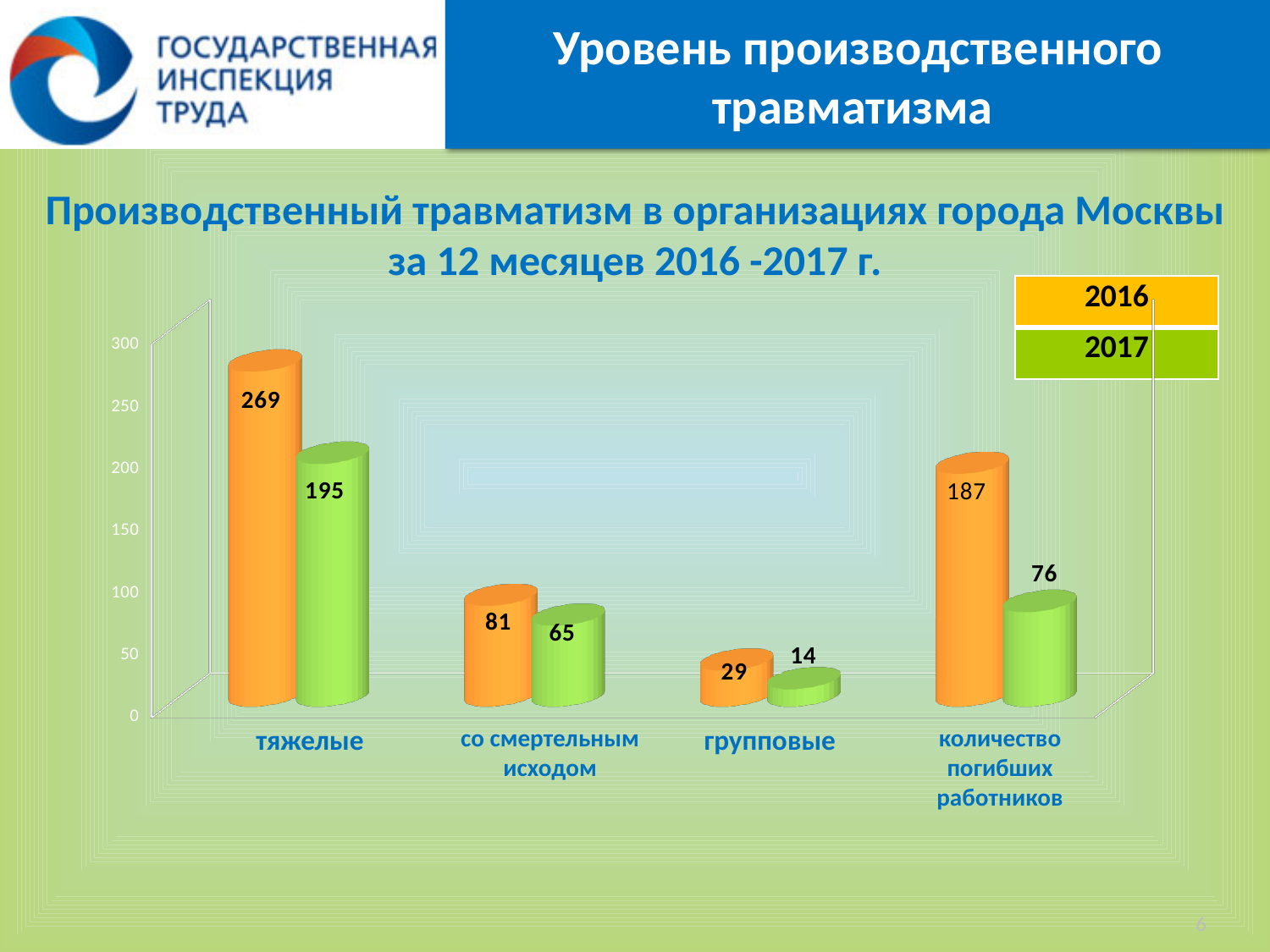
Which is larger: the 2016 value for групповые or the 2017 value for групповые? 2016 (29) How many series does the legend list? 2 What is the value for тяжелые in 2016? 269 What is the value for со смертельным исходом in 2017? 65 Which category has the highest value in 2016? тяжелые Which colour represents 2017 in the legend? green How many categories are shown on the x axis? 4 What is the value for количество погибших работников in 2016? 187 What is the difference between the 2016 and 2017 values for тяжелые? 74 What kind of chart is shown on the slide? bar chart What is the difference between the 2016 and 2017 values for количество погибших работников? 111 Which category has the lowest value in 2017? групповые